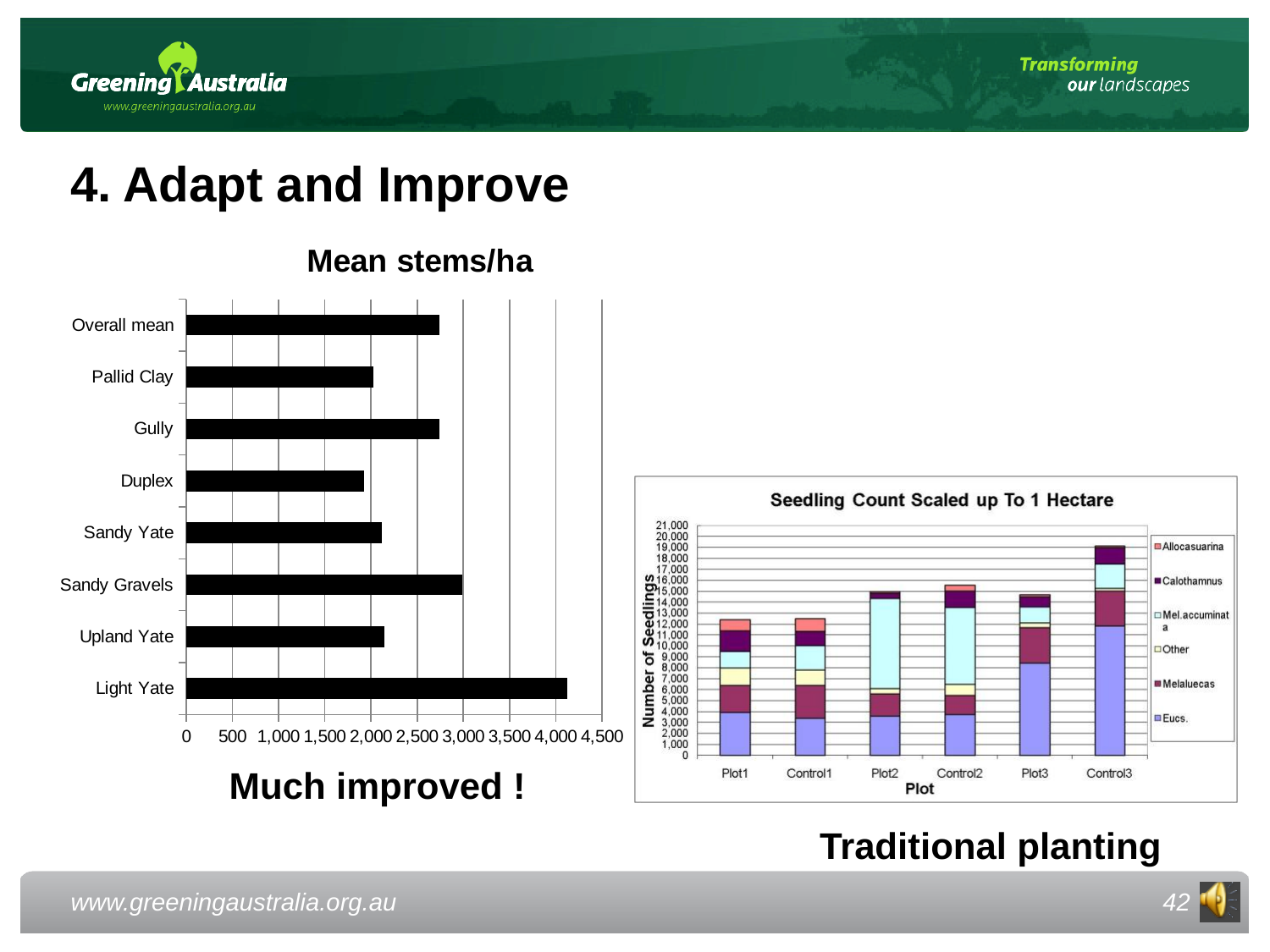
In the 'Mean stems/ha' chart, is the value for Duplex greater or less than 2,500? less What kind of chart is the 'Mean stems/ha' chart? bar chart In the 'Mean stems/ha' chart, which category has the highest value? Light Yate In the 'Mean stems/ha' chart, is the value for Light Yate greater or less than 3,500? greater In the 'Mean stems/ha' chart, which is larger, Sandy Gravels or Pallid Clay? Sandy Gravels In the 'Seedling Count Scaled up To 1 Hectare' chart, is the total for Control3 greater or less than 15,000? greater In the 'Mean stems/ha' chart, how many categories are plotted? 8 In the 'Seedling Count Scaled up To 1 Hectare' chart, how many plots are shown on the x axis? 6 In the 'Mean stems/ha' chart, which category has the lowest value? Duplex In the 'Seedling Count Scaled up To 1 Hectare' chart, which plot has the tallest stacked bar? Control3 In the 'Seedling Count Scaled up To 1 Hectare' chart, how many series does the legend list? 6